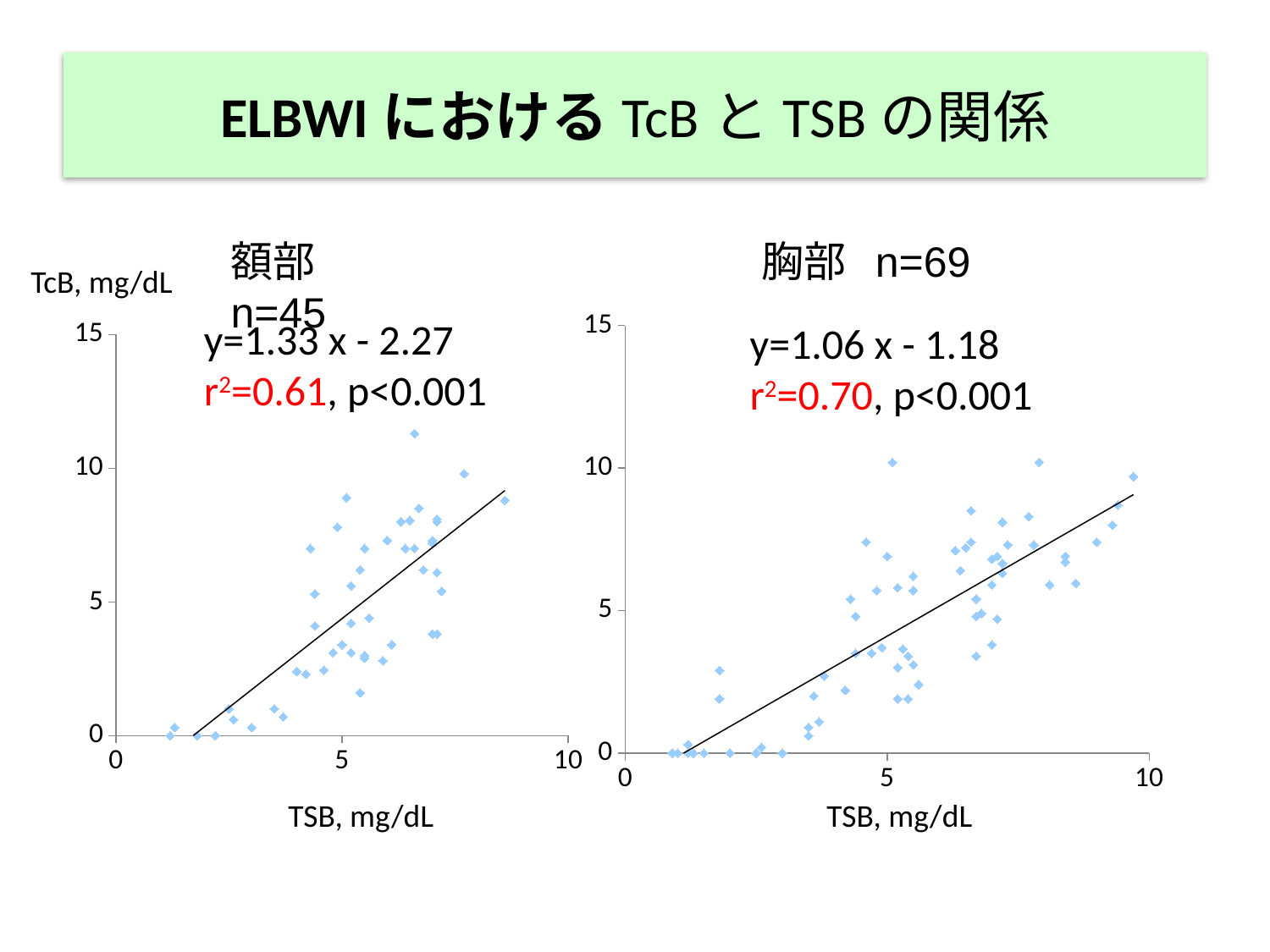
How many data points (n) are shown in the right chart (胸部)? 69 In the right chart (胸部), do the TcB values generally rise or fall as TSB increases? rise What kind of chart is the right chart (胸部)? scatter plot What kind of chart is the left chart (額部)? scatter plot How many data points (n) are shown in the left chart (額部)? 45 What is the label of the x axis on both charts? TSB, mg/dL What is the r² value shown on the left chart (額部)? 0.61 What is the regression equation shown on the right chart (胸部)? y=1.06 x - 1.18 In the left chart (額部), do the TcB values generally rise or fall as TSB increases? rise Which chart has the higher r² value, the left (額部) or the right (胸部)? right (胸部) In the left chart (額部), is the highest TcB data point greater or less than 10? greater What is the r² value shown on the right chart (胸部)? 0.70